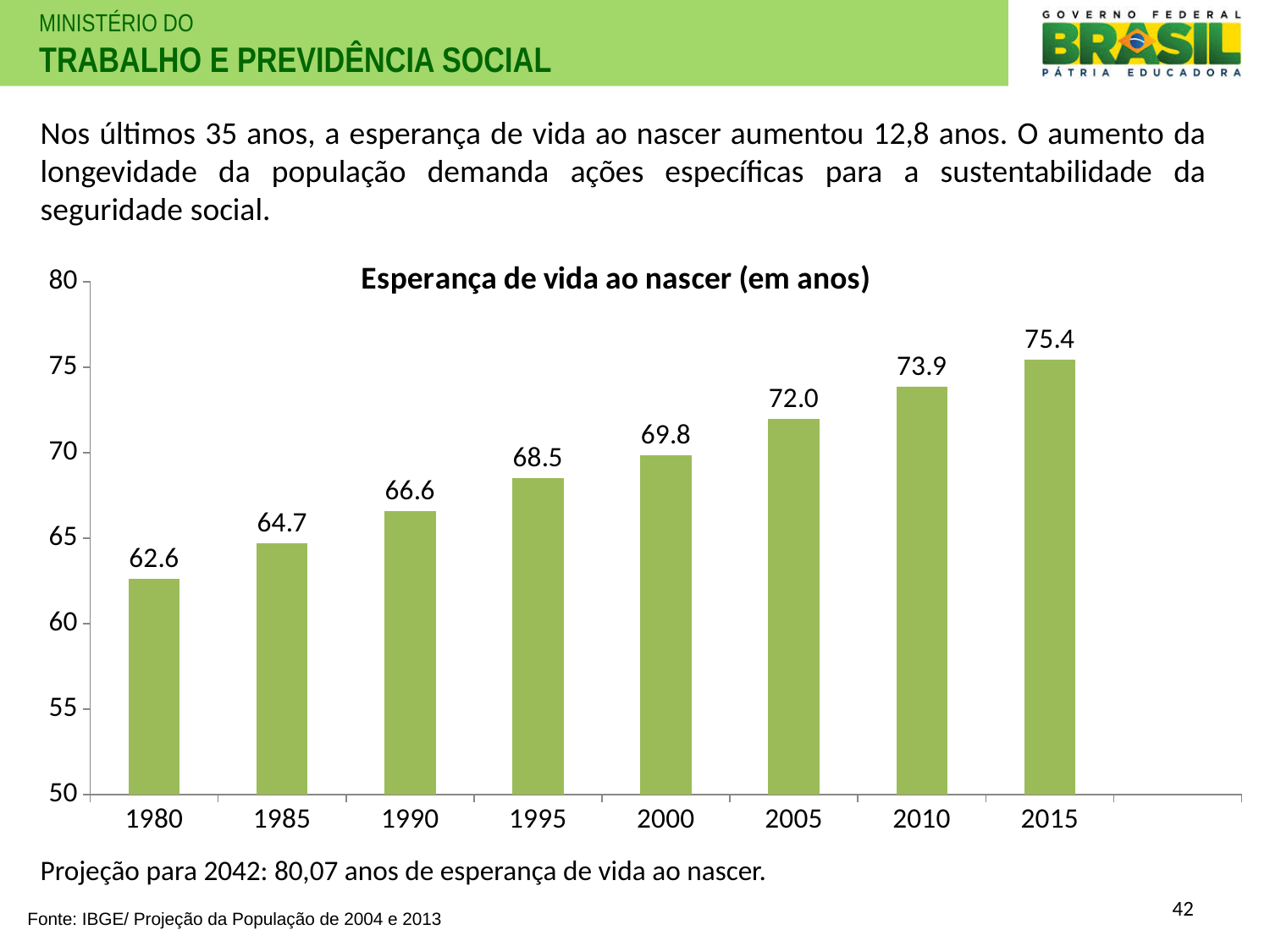
Which year has the lowest life expectancy at birth in the chart? 1980 What kind of chart is shown on the slide? bar chart Which is larger, the value for 1990 or the value for 2010? 2010 What is the value shown for 2000 in the chart? 69.8 What is the life expectancy at birth shown for 1980? 62.6 What is the difference between the values for 2015 and 1980? 12.8 How many years are shown on the x axis of the chart? 8 What is the value shown for 2015? 75.4 Is the value for 1985 greater or less than 65? less What is the difference between the values for 2005 and 1995? 3.5 Do the values rise or fall from 1980 to 2015? rise Which year has the highest life expectancy at birth in the chart? 2015